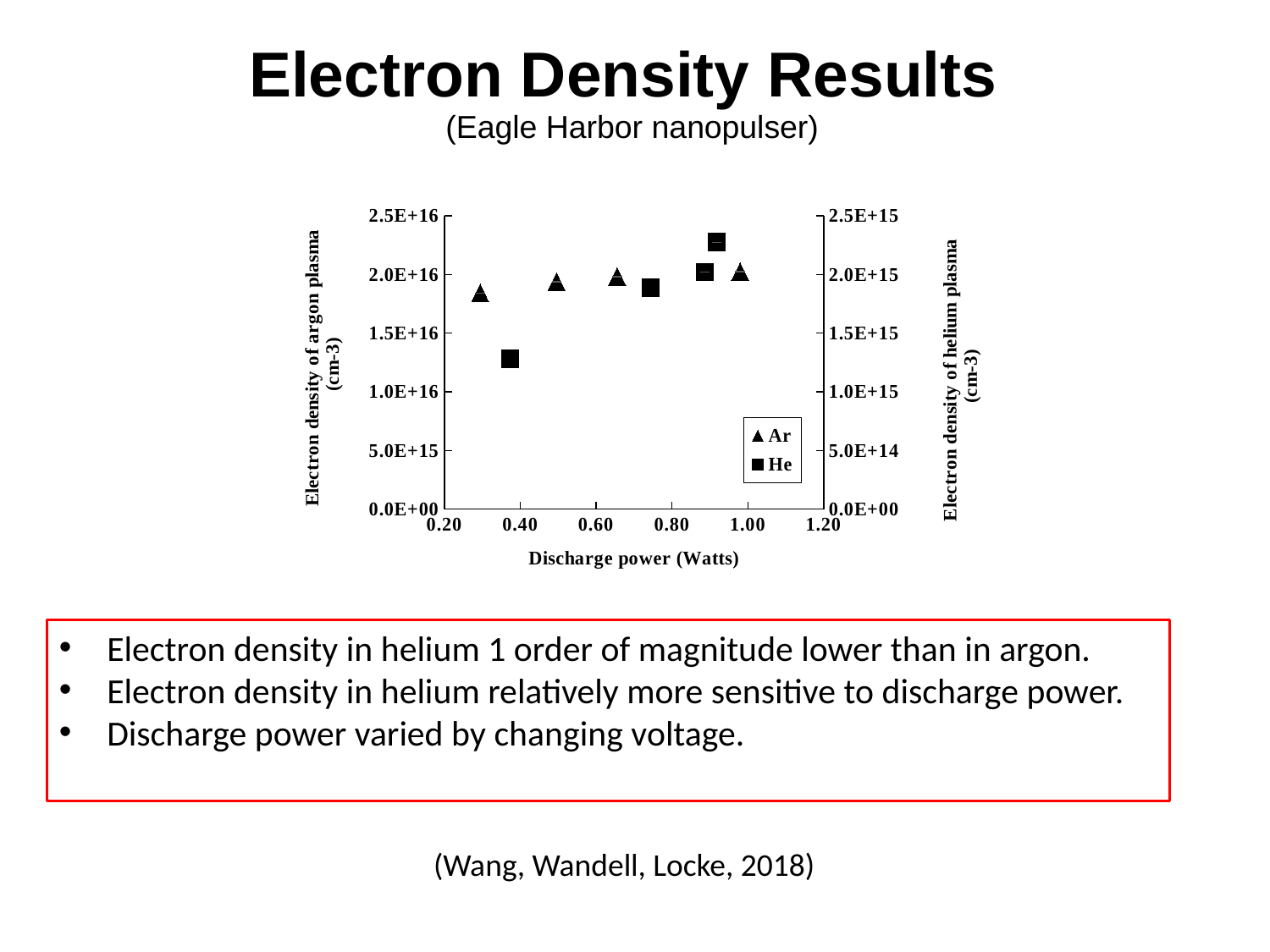
Which He point has the lowest electron density: the one near 0.40 W or the one near 0.90 W? the one near 0.40 W How many series does the legend list? 2 Is the value of the lowest He point (near 0.40 W) greater or less than 1.5E+15 on the right axis? less How many He data points are plotted? 4 What kind of chart is shown on the slide? scatter chart Do the He electron density values generally rise or fall as discharge power increases? rise Is the value of the highest He point (near 0.90 W) greater or less than 2.0E+15 on the right axis? greater What are the two series named in the legend? Ar and He What is the title of the x axis? Discharge power (Watts) Is the value of the Ar point at the lowest discharge power (near 0.30 W) greater or less than 2.0E+16 on the left axis? less